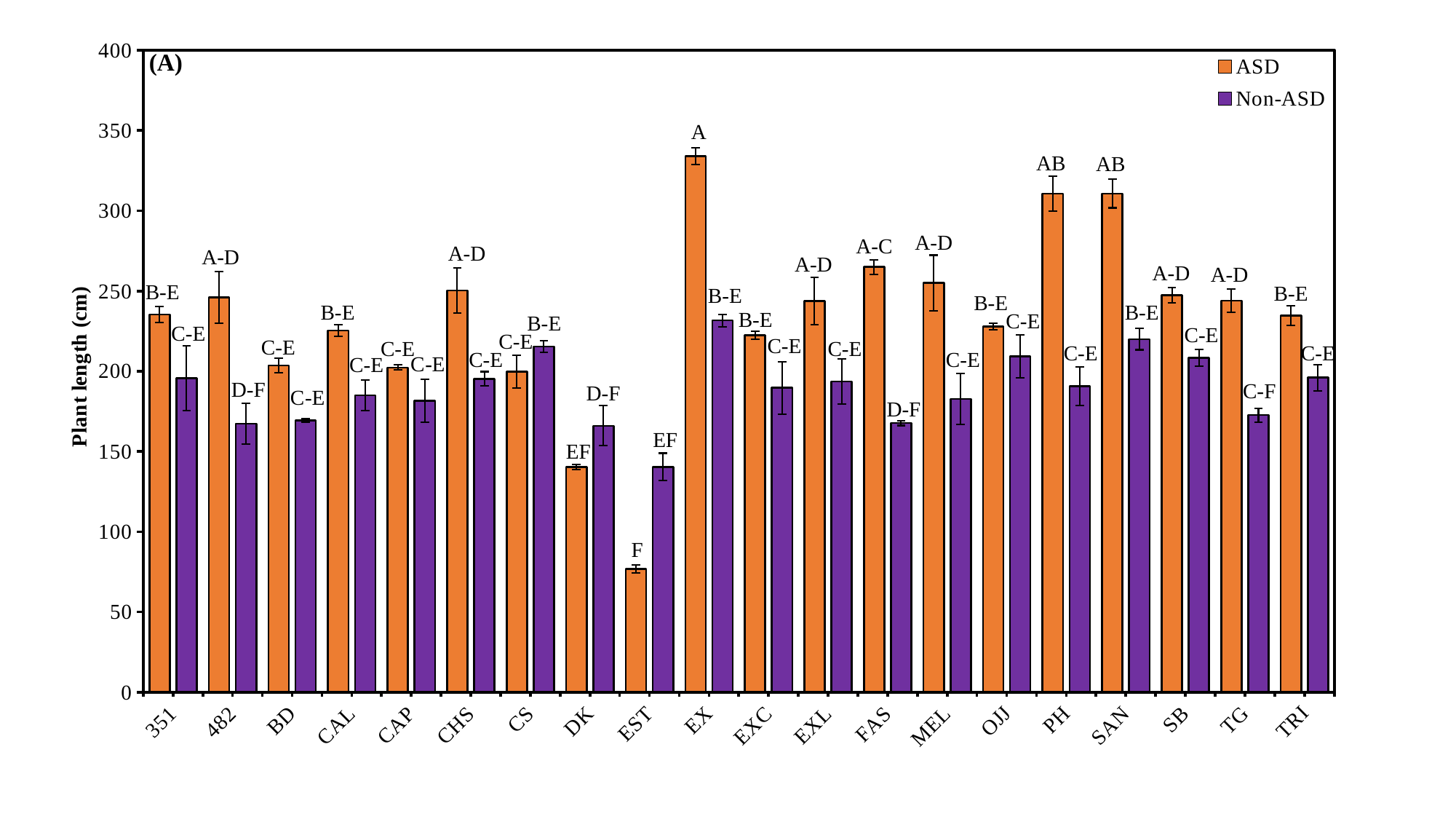
How many categories are shown along the x axis? 20 Is the ASD value for EST greater or less than 100? less How many series does the legend list? 2 Which category has the lowest ASD plant length? EST For 482, which is larger: the ASD value or the Non-ASD value? ASD Which category has the highest Non-ASD plant length? EX What is the label on the y axis? Plant length (cm) Is the ASD value for EX greater or less than 300? greater Is the Non-ASD value for TG greater or less than 200? less For EST, which is larger: the ASD value or the Non-ASD value? Non-ASD What kind of chart is shown on the slide? bar chart Which category has the highest ASD plant length? EX